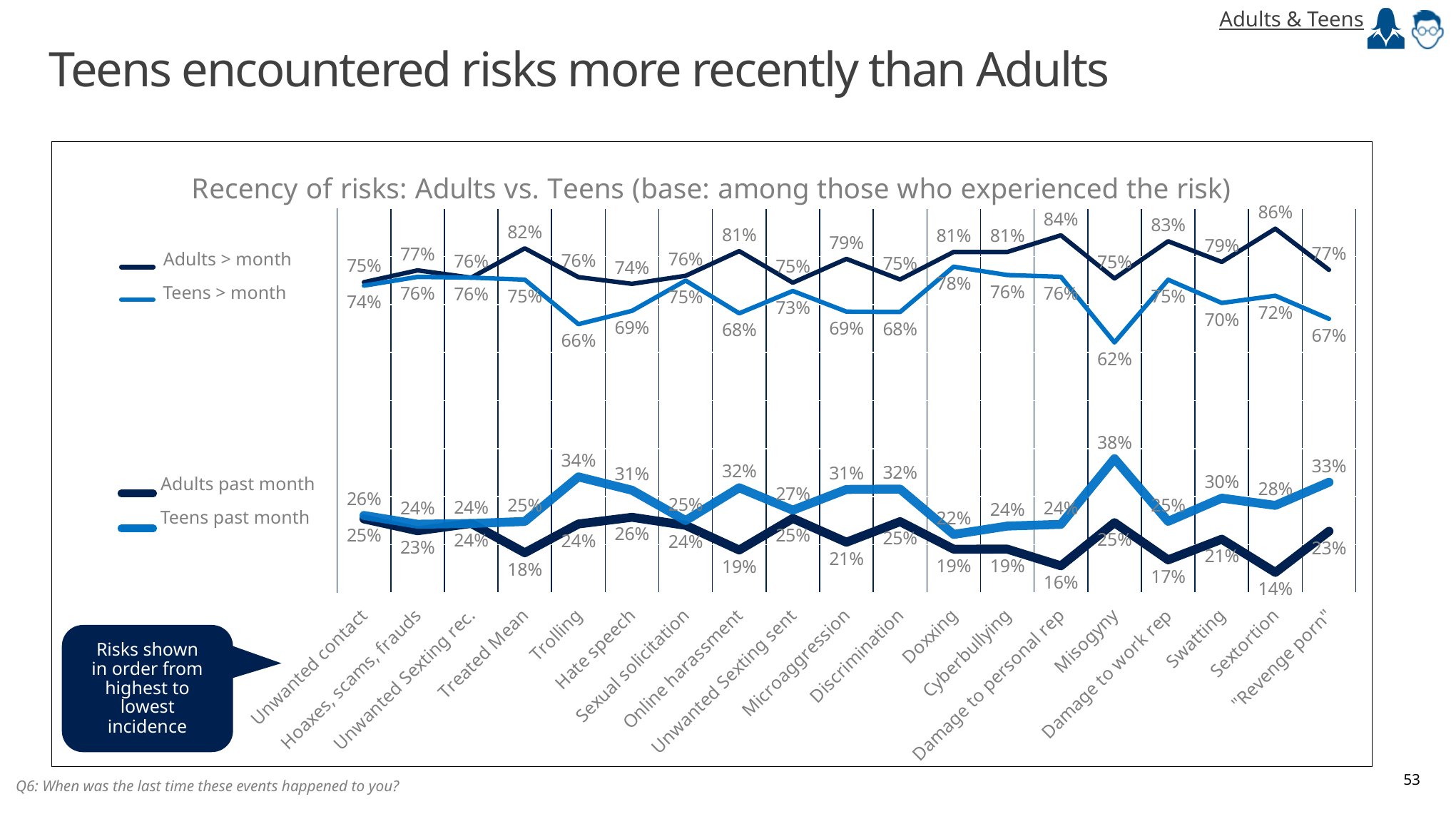
Which risk has the highest value for Adults > month? Sextortion Which risk has the lowest value for Teens > month? Misogyny What is the difference between Teens past month and Adults past month for Misogyny? 13% What is the value for Adults > month for Sextortion? 86% For Online harassment, which is larger: Adults > month or Teens > month? Adults > month How many series does the legend list? 4 What is the value for Teens past month for Misogyny? 38% How many risk categories are plotted along the x axis? 19 What is the title of the chart? Recency of risks: Adults vs. Teens (base: among those who experienced the risk) What type of chart is shown on the slide? line chart Which risk has the lowest value for Adults past month? Sextortion What is the value for Teens > month for Trolling? 66%